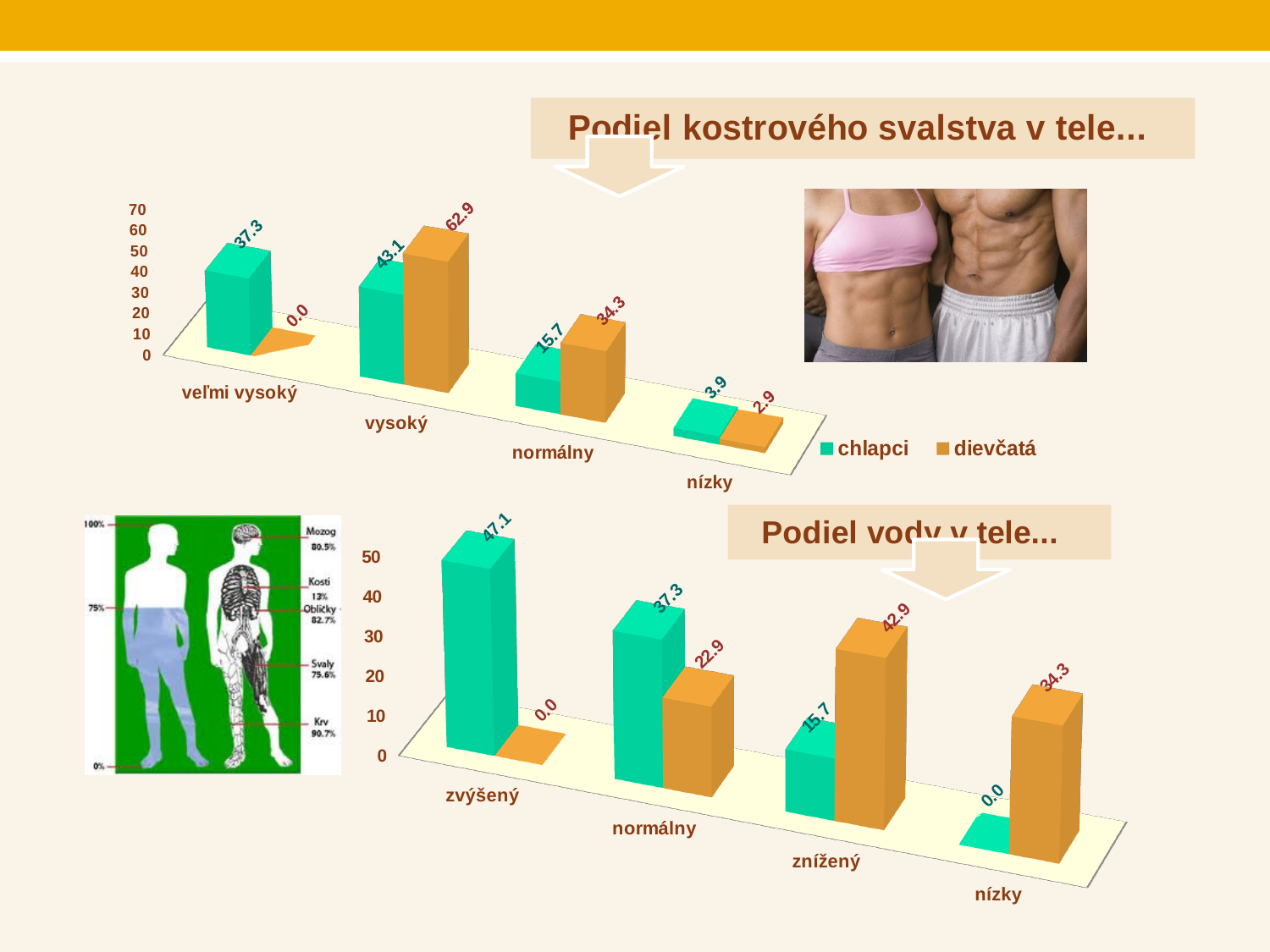
In the chart 'Podiel kostrového svalstva v tele...', which category has the highest value for chlapci? vysoký What kind of chart is 'Podiel vody v tele...'? bar chart In the chart 'Podiel vody v tele...', what is the value of the green (chlapci) bar in the category zvýšený? 47.1 In the chart 'Podiel kostrového svalstva v tele...', what is the difference between dievčatá and chlapci in the category normálny? 18.6 In the chart 'Podiel kostrového svalstva v tele...', what is the value for dievčatá in the category vysoký? 62.9 In the chart 'Podiel kostrového svalstva v tele...', how many categories are shown on the x axis? 4 In the chart 'Podiel vody v tele...', is the green (chlapci) bar or the orange (dievčatá) bar larger in the category normálny? green (chlapci) In the chart 'Podiel vody v tele...', do the green (chlapci) values rise or fall from zvýšený to nízky? fall In the chart 'Podiel kostrového svalstva v tele...', how many series does the legend list? 2 In the chart 'Podiel vody v tele...', what is the value of the orange (dievčatá) bar in the category znížený? 42.9 In the chart 'Podiel kostrového svalstva v tele...', what is the value for chlapci in the category veľmi vysoký? 37.3 In the chart 'Podiel vody v tele...', which category has the lowest value for the green (chlapci) bars? nízky